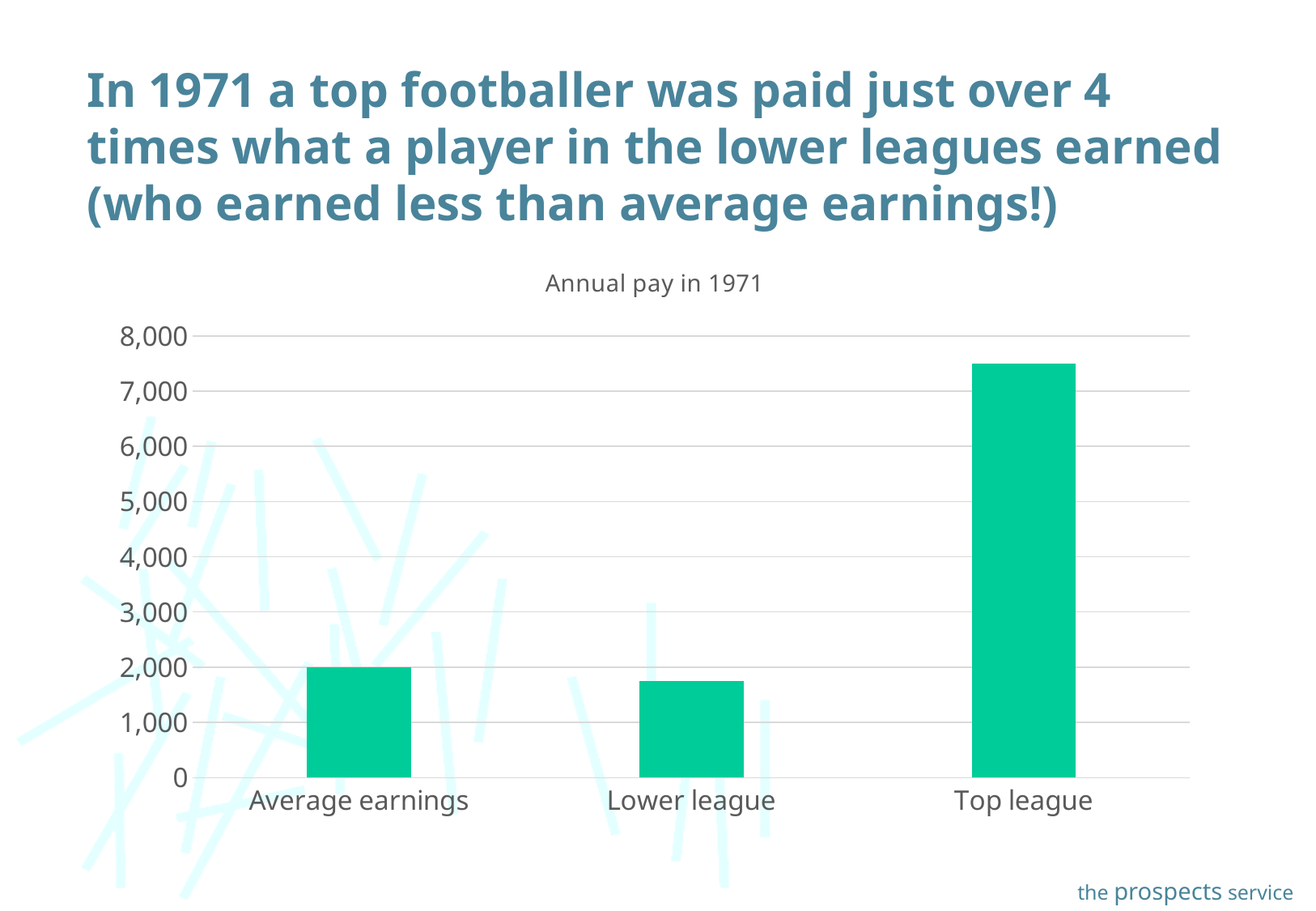
Is the value for Lower league greater or less than 2,000? less Is the value for Top league greater or less than 8,000? less What is the title of the chart? Annual pay in 1971 What is the value for Average earnings in the chart? 2,000 Is the value for Top league greater or less than 7,000? greater What colour are the bars in the chart? Green Which category has the highest annual pay in the chart? Top league Which is larger, the value for Average earnings or the value for Lower league? Average earnings What kind of chart is shown on the slide? Bar chart How many categories are plotted in the chart? 3 Which category has the lowest annual pay in the chart? Lower league